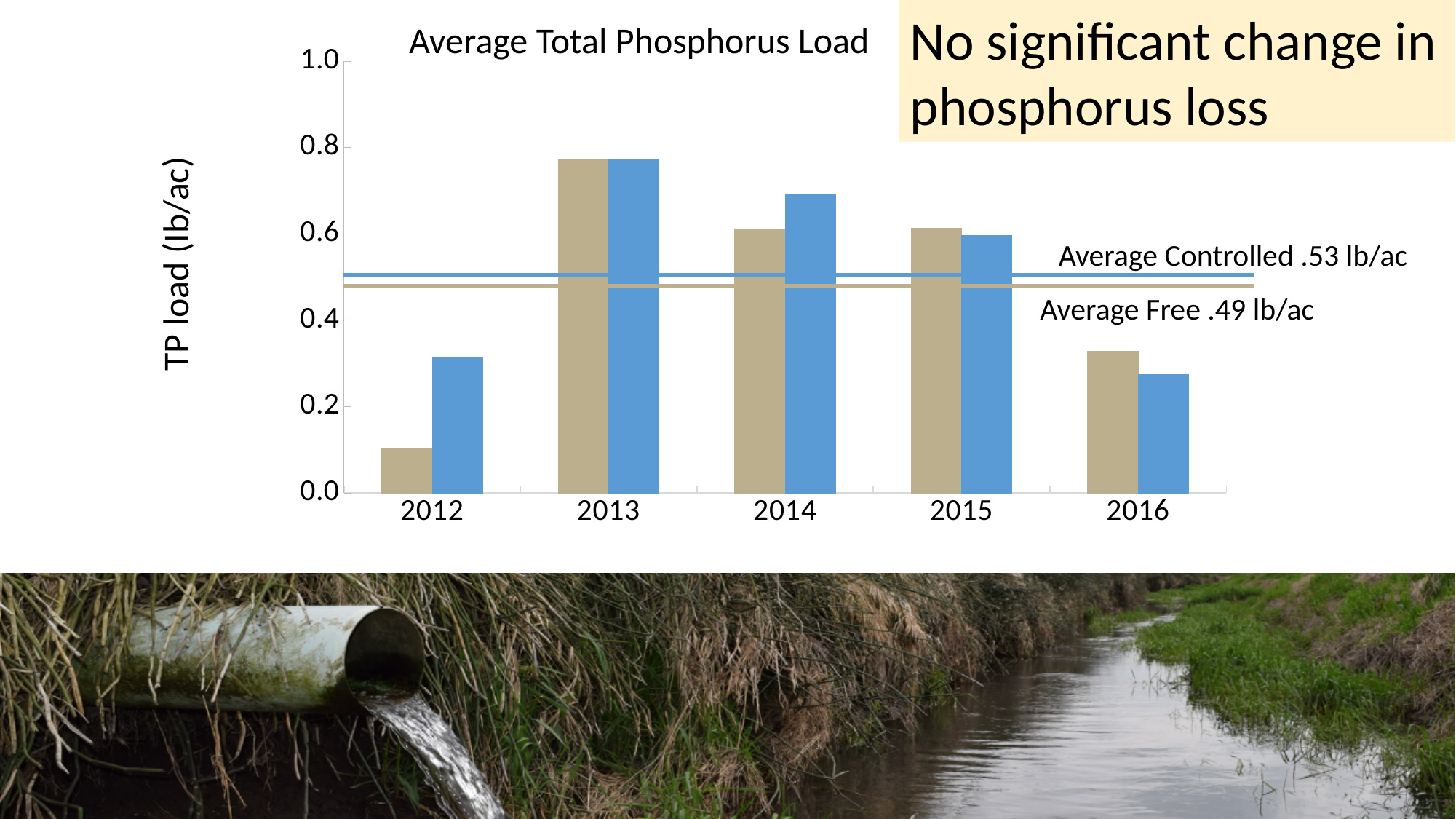
What kind of chart is shown on the slide? bar chart How many years are shown on the x axis of the chart? 5 Is the value of the blue bar for 2012 greater or less than 0.4? less What is the Average Free value shown on the chart? .49 lb/ac Is the value of the tan bar for 2013 greater or less than 0.6? greater What is the label on the vertical axis of the chart? TP load (lb/ac) Which is larger, the Average Controlled value or the Average Free value? Average Controlled Is the value of the tan bar for 2012 greater or less than 0.2? less In which year is the blue bar the highest? 2013 In which year is the tan bar the lowest? 2012 What is the Average Controlled value shown on the chart? .53 lb/ac What is the title of the chart? Average Total Phosphorus Load